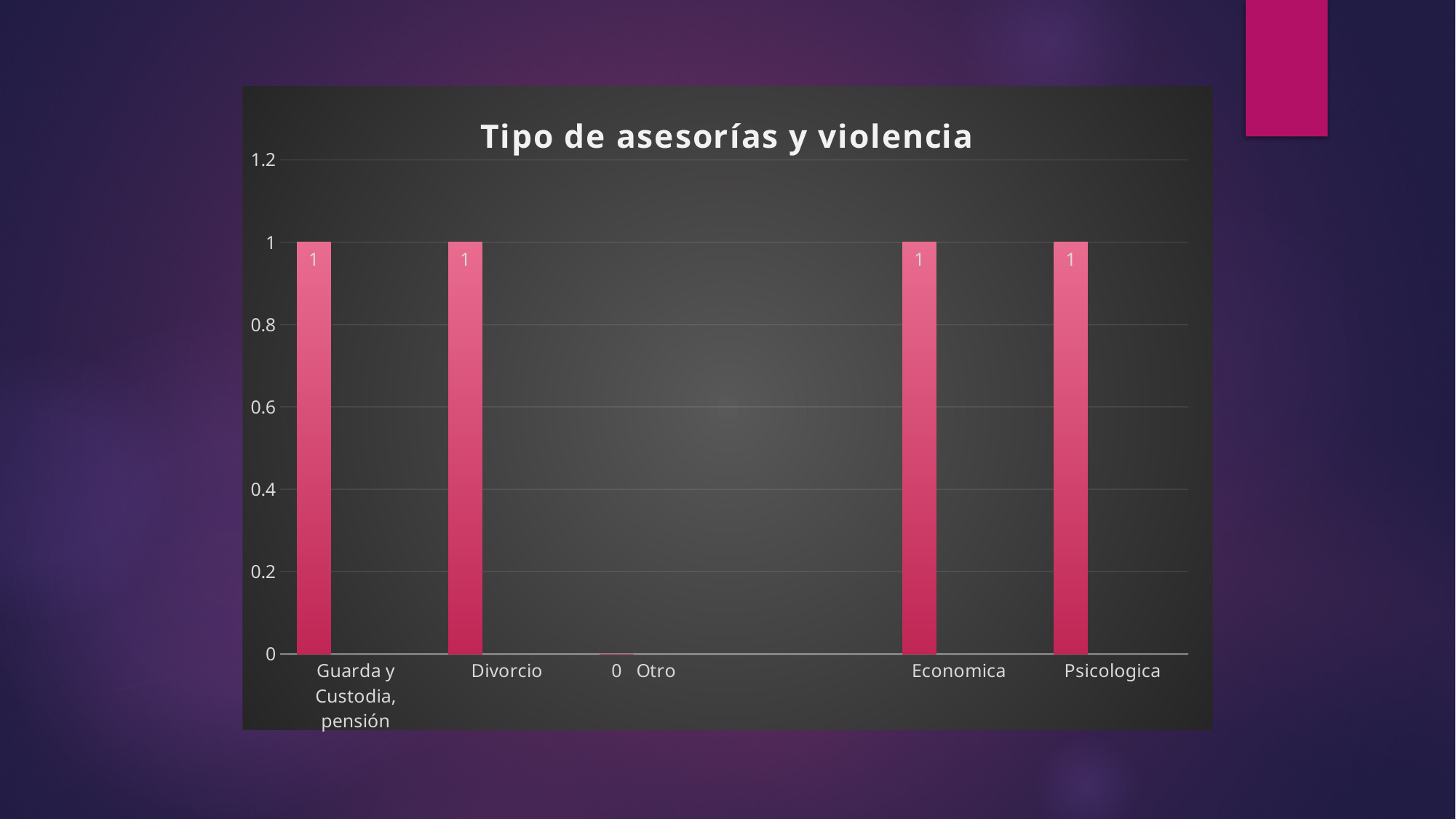
What is the value for Guarda y Custodia, pensión? 1 Is the value for Psicologica greater or less than 0.8? greater What is the value for Otro? 0 Which category has the lowest value? Otro What kind of chart is shown on the slide? bar chart What is the value for Psicologica? 1 What is the title of the chart? Tipo de asesorías y violencia What is the value for Economica? 1 Is the value for Otro greater or less than 0.2? less What is the value for Divorcio? 1 Which is larger, the value for Economica or the value for Otro? Economica What is the difference between the values for Divorcio and Otro? 1